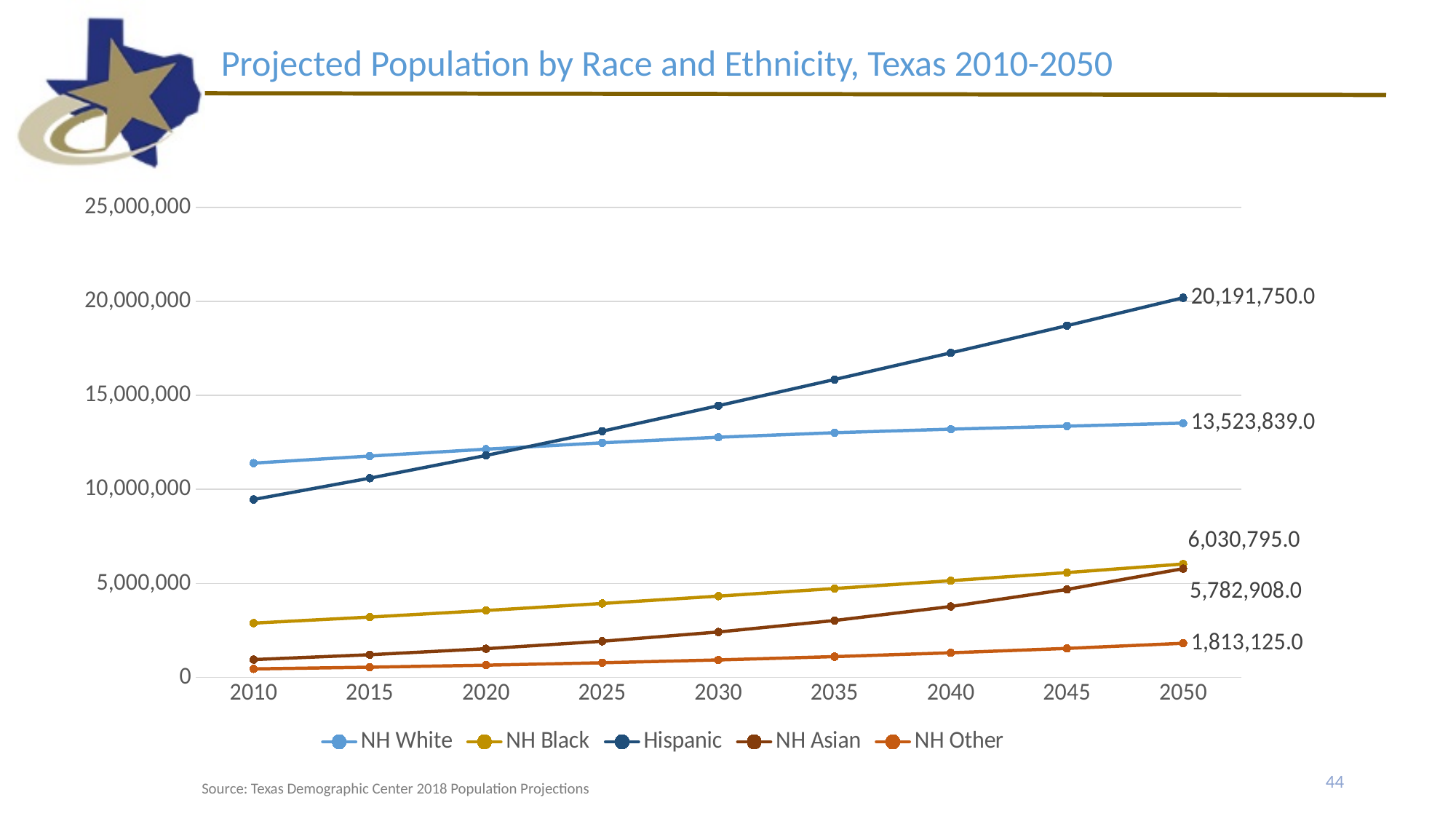
Which group has the lowest projected population in 2050? NH Other In 2010, which is larger: the NH White population or the Hispanic population? NH White Which group has the highest projected population in 2050? Hispanic What kind of chart is shown on the slide? line chart What is the projected NH Asian population in 2050? 5,782,908.0 What is the projected Hispanic population in 2050? 20,191,750.0 What is the projected NH White population in 2050? 13,523,839.0 What is the projected NH Other population in 2050? 1,813,125.0 What is the difference between the Hispanic and NH White projected populations in 2050? 6,667,911.0 How many series does the legend list? 5 Is the Hispanic population in 2010 greater or less than 10,000,000? less How many years are shown on the x axis? 9